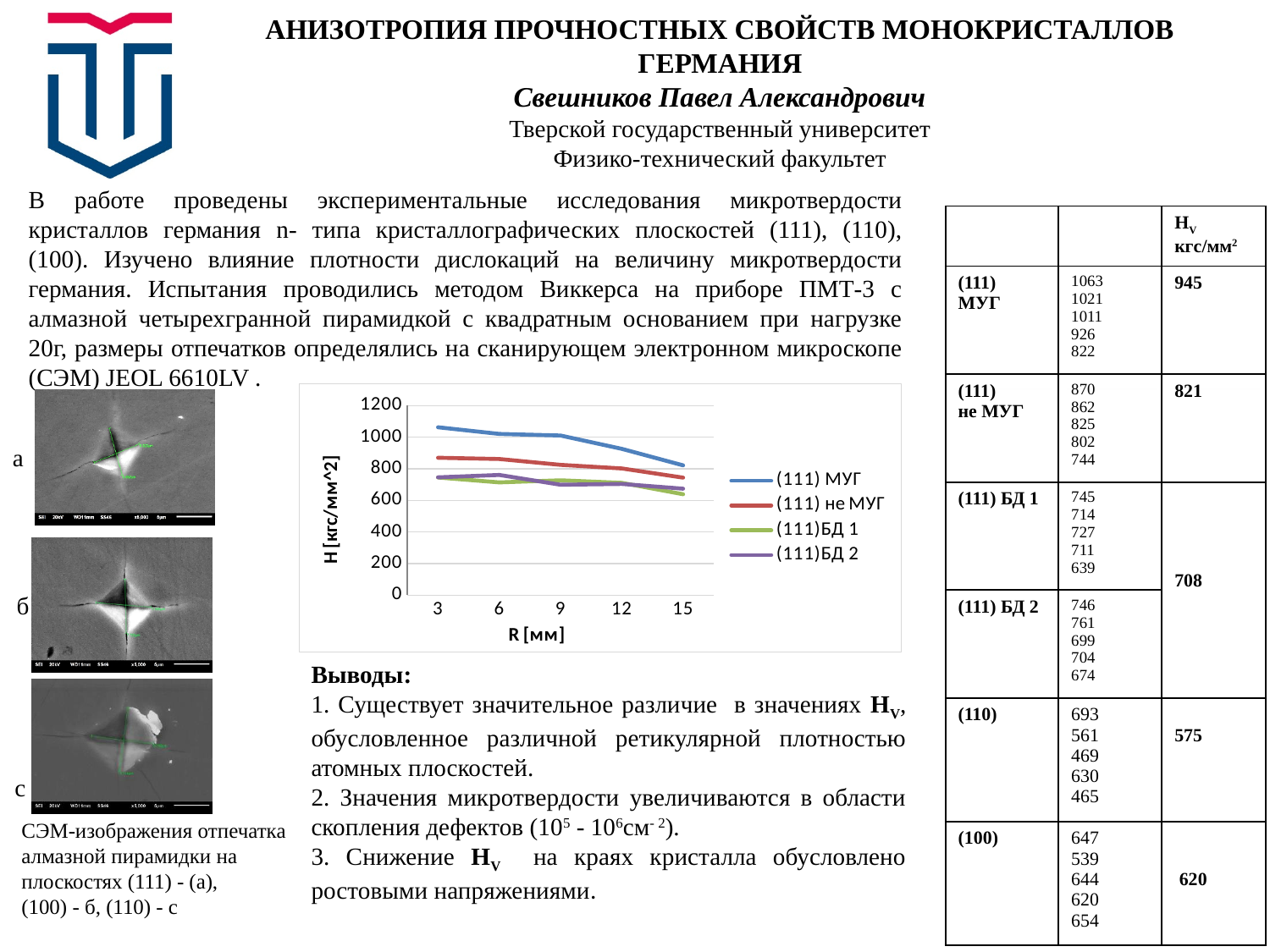
Which series has the highest values across the chart? (111) МУГ What is the label of the x axis of the chart? R [мм] What type of chart is shown on the slide? line chart How many series does the chart legend list? 4 Is the value for (111) МУГ at R = 3 greater or less than 1000? greater What is the label of the y axis of the chart? H [кгс/мм^2] Is the value for (111)БД 1 at R = 15 greater or less than 800? less Does the (111) МУГ series rise or fall as R increases from 3 to 15? fall At R = 9, which series has the larger value: (111) МУГ or (111) не МУГ? (111) МУГ How many R values are plotted along the x axis of the chart? 5 Is the value for (111) не МУГ at R = 3 greater or less than 800? greater